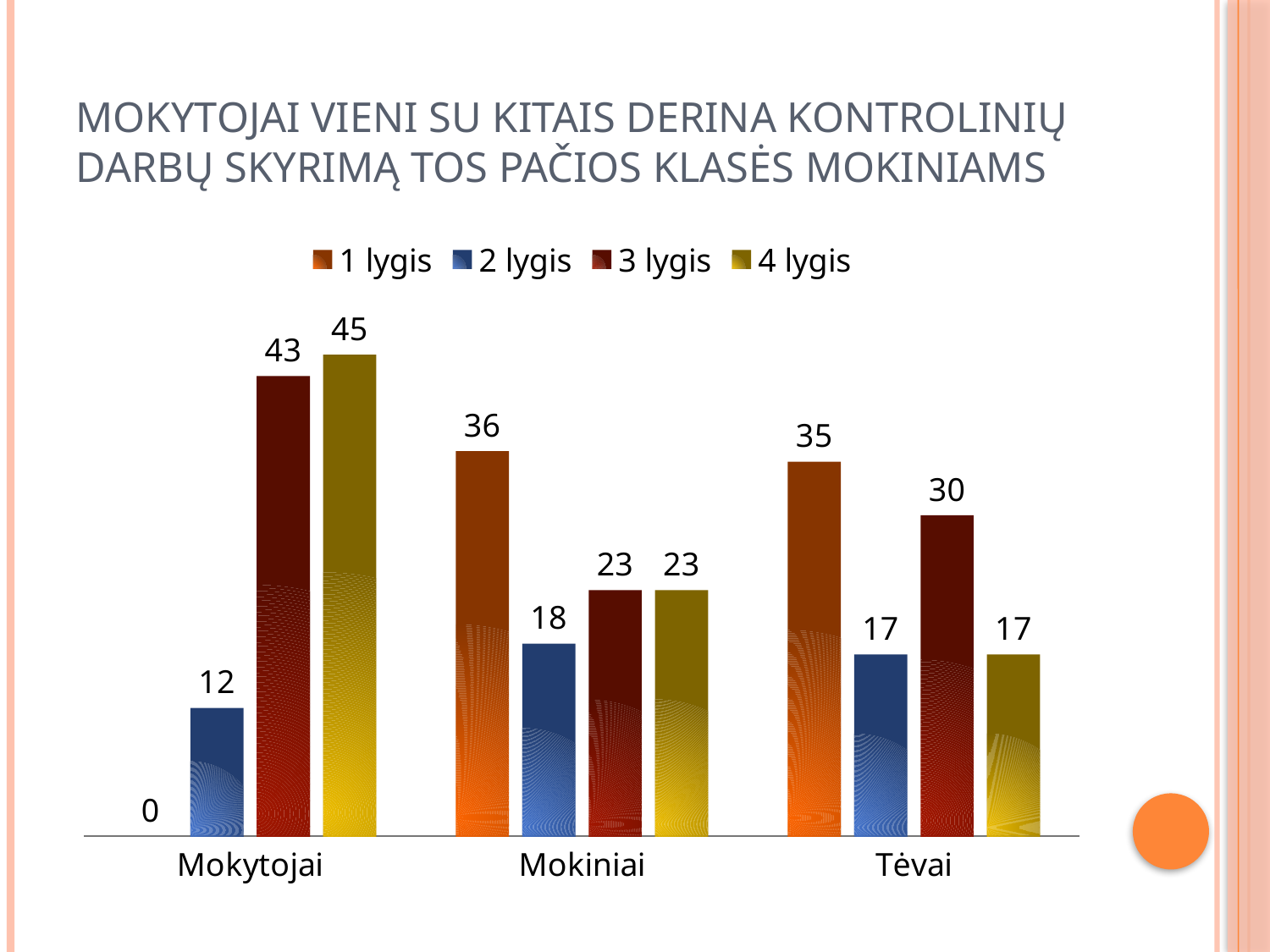
What is the value for 1 lygis in the Mokytojai category? 0 How many categories are shown on the x axis? 3 Which series has the highest value in the Mokytojai category? 4 lygis How many series does the legend list? 4 What is the value for 1 lygis in the Mokiniai category? 36 What is the difference between the 1 lygis and 2 lygis values in the Mokiniai category? 18 Which is larger: the 3 lygis value for Tėvai or the 3 lygis value for Mokiniai? Tėvai What is the value for 3 lygis in the Mokytojai category? 43 What is the name of the third category on the x axis? Tėvai Which series has the lowest value in the Tėvai category? 2 lygis and 4 lygis (both 17) What is the value for 2 lygis in the Tėvai category? 17 What kind of chart is shown on the slide? Bar chart